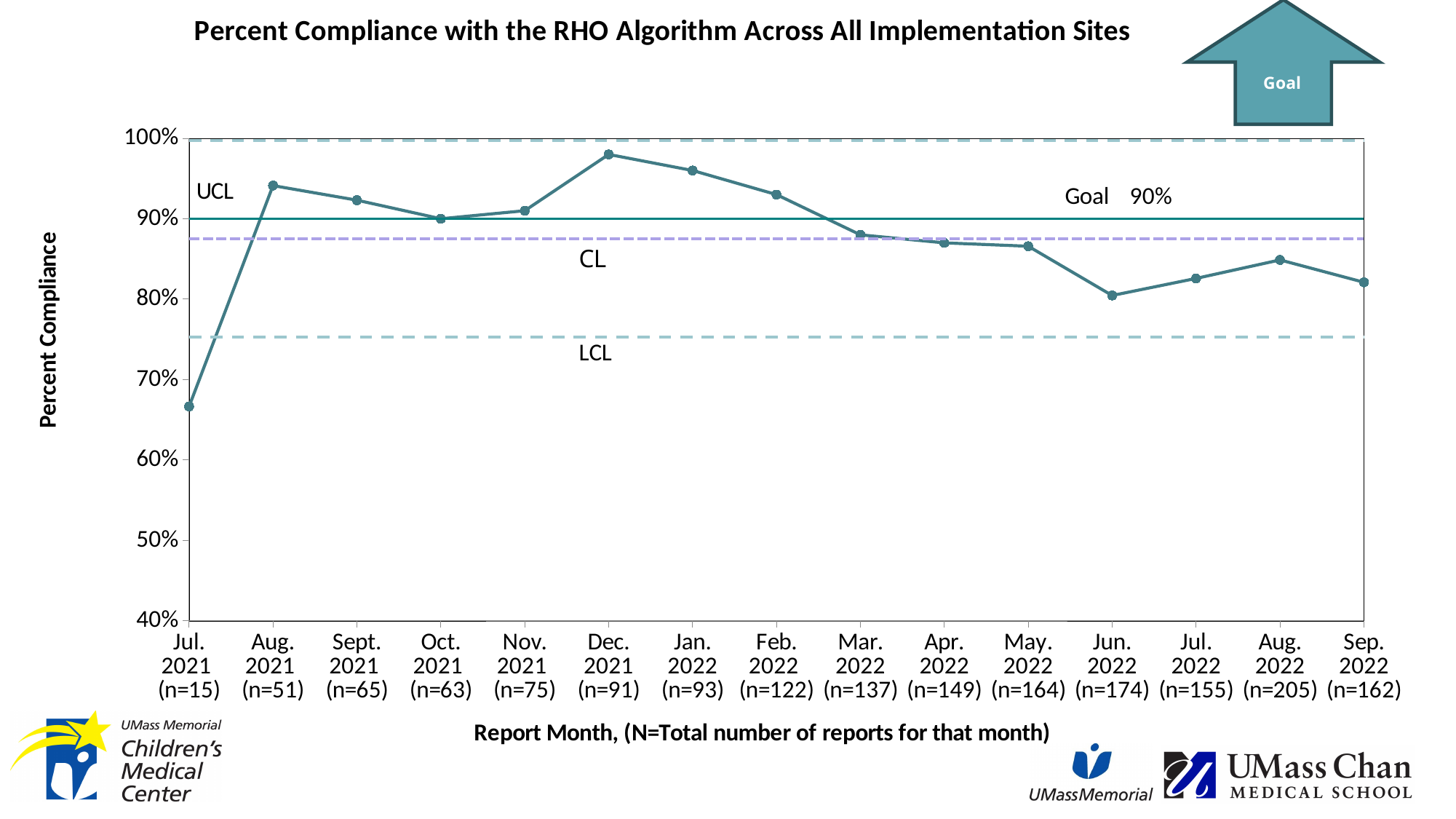
Is the value for Jun. 2022 greater or less than 90%? less What goal value is labelled on the chart? 90% Which report month has the highest percent compliance? Dec. 2021 Do the values rise or fall from Dec. 2021 to Jun. 2022? fall How many report months are plotted on the x axis? 15 Which report month has the lowest percent compliance? Jul. 2021 Is the value for Dec. 2021 greater or less than 90%? greater Which is larger, the value for Aug. 2021 or the value for Sep. 2022? Aug. 2021 What is the label of the y axis? Percent Compliance What is the title of the chart? Percent Compliance with the RHO Algorithm Across All Implementation Sites What kind of chart is shown on the slide? line chart Is the value for Jul. 2021 greater or less than 70%? less